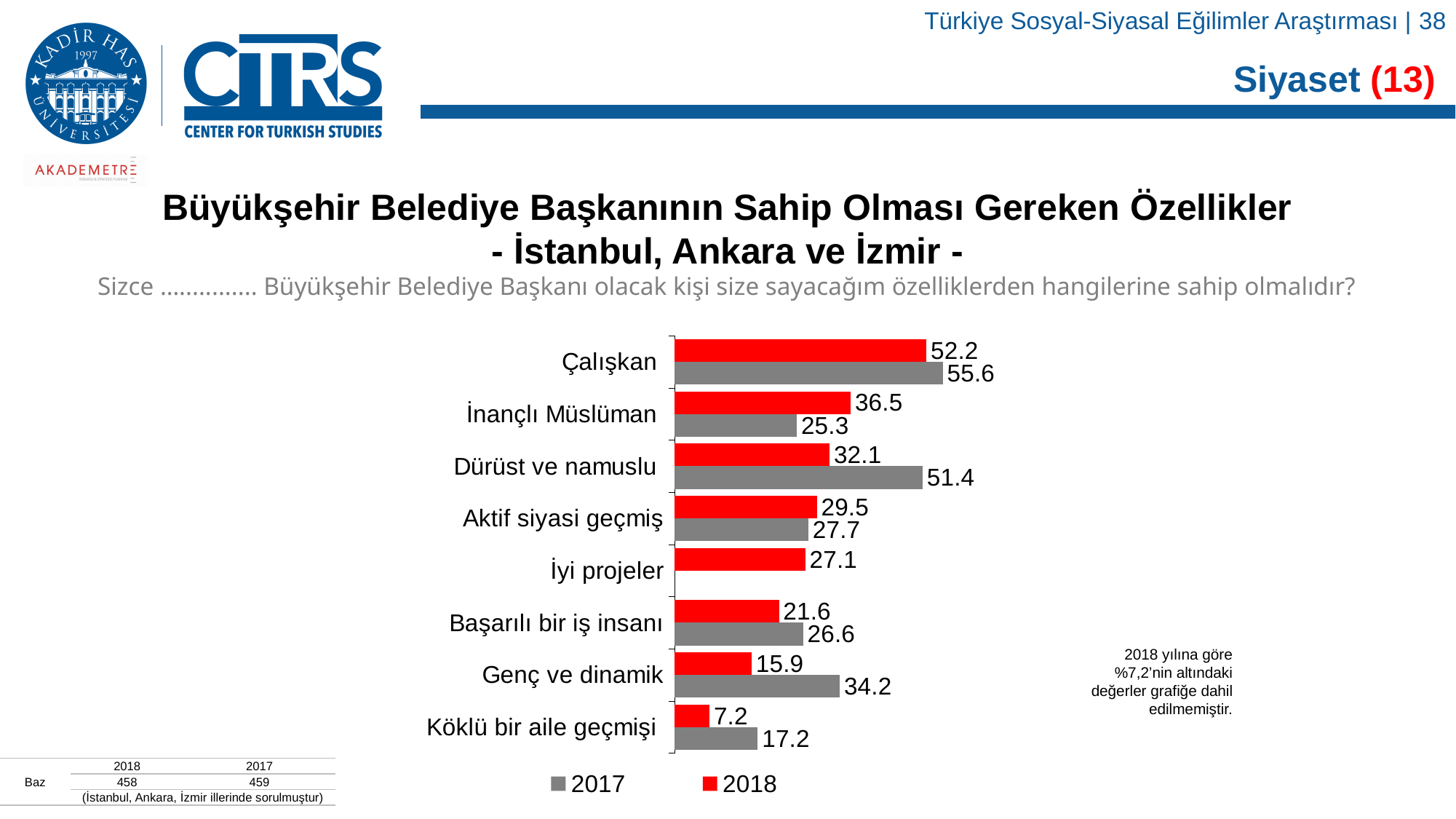
Which category has the lowest 2018 value? Köklü bir aile geçmişi What is the 2017 value for Dürüst ve namuslu? 51.4 What is the 2017 value for Köklü bir aile geçmişi? 17.2 What is the difference between the 2017 and 2018 values for Dürüst ve namuslu? 19.3 How many categories are shown in the chart? 8 What is the 2018 value for Genç ve dinamik? 15.9 Which category has a 2018 value but no 2017 bar shown? İyi projeler Which is larger for İnançlı Müslüman, the 2017 value or the 2018 value? 2018 How many series does the legend list? 2 What is the 2018 value for Çalışkan? 52.2 Which category has the highest 2018 value? Çalışkan What kind of chart is shown on the slide? Bar chart